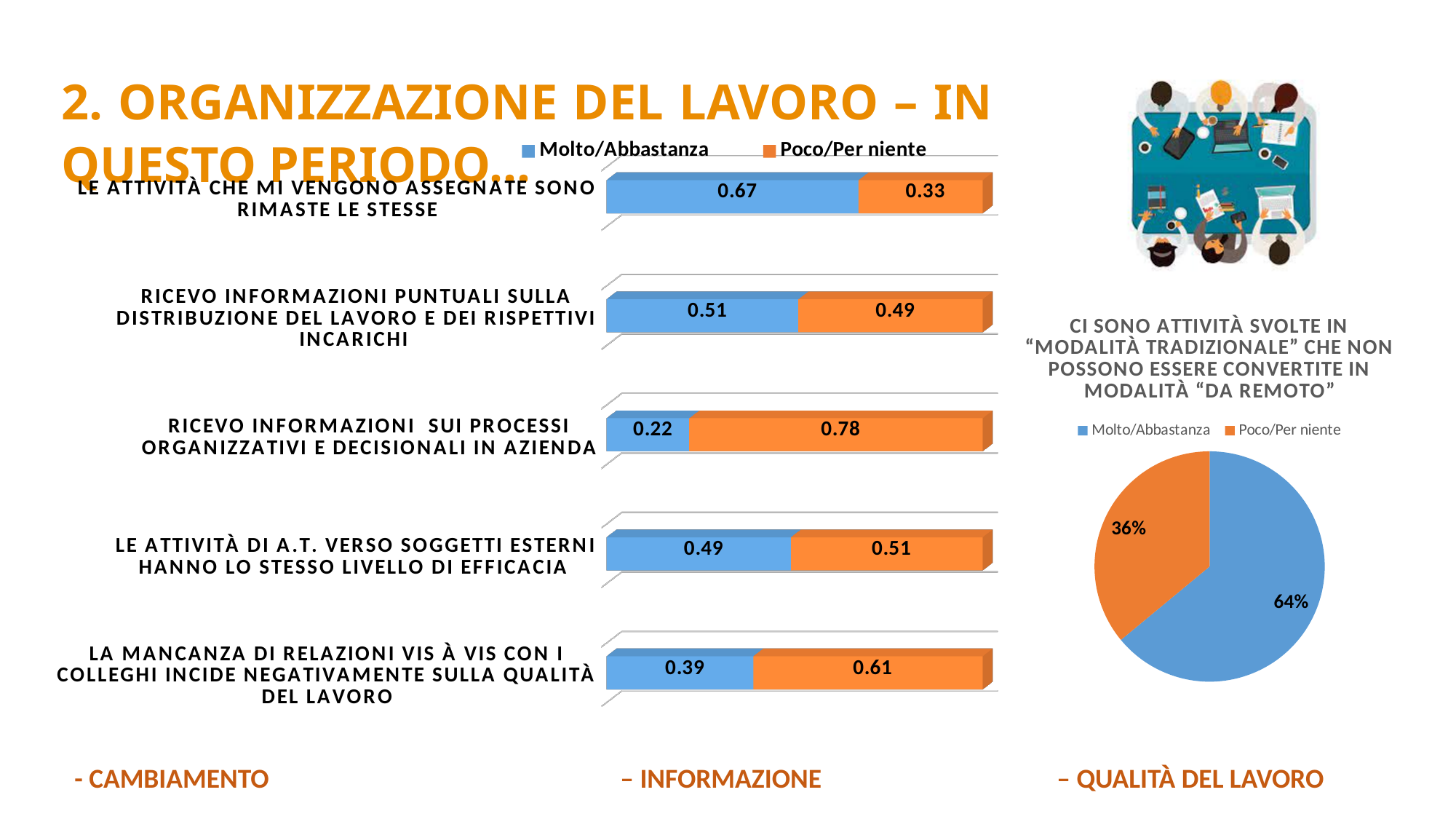
In the stacked bar chart on the left, what is the difference between the Poco/Per niente and Molto/Abbastanza values for "Ricevo informazioni sui processi organizzativi e decisionali in azienda"? 0.56 In the stacked bar chart on the left, which category has the lowest Molto/Abbastanza value? Ricevo informazioni sui processi organizzativi e decisionali in azienda In the stacked bar chart on the left, what is the Poco/Per niente value for "Ricevo informazioni sui processi organizzativi e decisionali in azienda"? 0.78 What kind of chart is the chart on the left of the slide? Bar chart How many categories does the stacked bar chart on the left show? 5 In the stacked bar chart on the left, which category has the highest Molto/Abbastanza value? Le attività che mi vengono assegnate sono rimaste le stesse In the stacked bar chart on the left, for "Le attività di A.T. verso soggetti esterni hanno lo stesso livello di efficacia", which is larger: Molto/Abbastanza or Poco/Per niente? Poco/Per niente In the stacked bar chart on the left, what is the Molto/Abbastanza value for "Le attività che mi vengono assegnate sono rimaste le stesse"? 0.67 In the pie chart on the right, what share is Molto/Abbastanza? 64% In the pie chart on the right, what is the difference between the Molto/Abbastanza and Poco/Per niente shares? 28% How many series does the legend of the stacked bar chart on the left list? 2 In the stacked bar chart on the left, what is the Molto/Abbastanza value for "La mancanza di relazioni vis à vis con i colleghi incide negativamente sulla qualità del lavoro"? 0.39